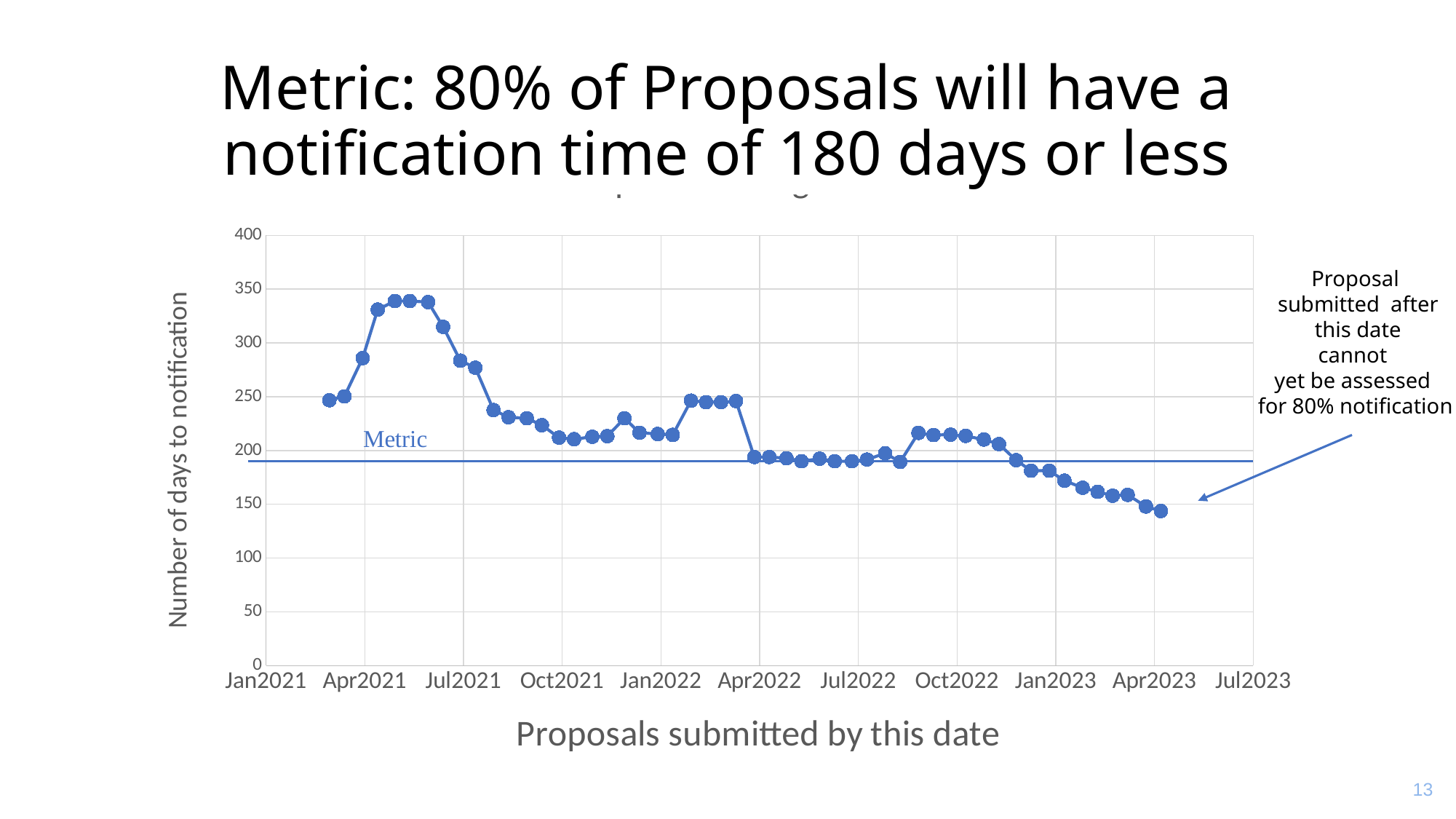
Do the values rise or fall along the x axis between Oct2022 and Apr2023? fall Is the value for proposals submitted by Apr2023 greater or less than 200? less Do the values rise or fall along the x axis between Jul2021 and Oct2021? fall Is the value for proposals submitted by Jul2022 greater or less than 250? less Is the value for proposals submitted by Apr2021 greater or less than 250? greater Around which x-axis date does the line reach its lowest value? Apr2023 Which is larger, the value for proposals submitted by Apr2021 or the value for proposals submitted by Apr2023? Apr2021 What is the label of the x axis? Proposals submitted by this date What kind of chart is shown on the slide? line chart What is the label of the y axis? Number of days to notification